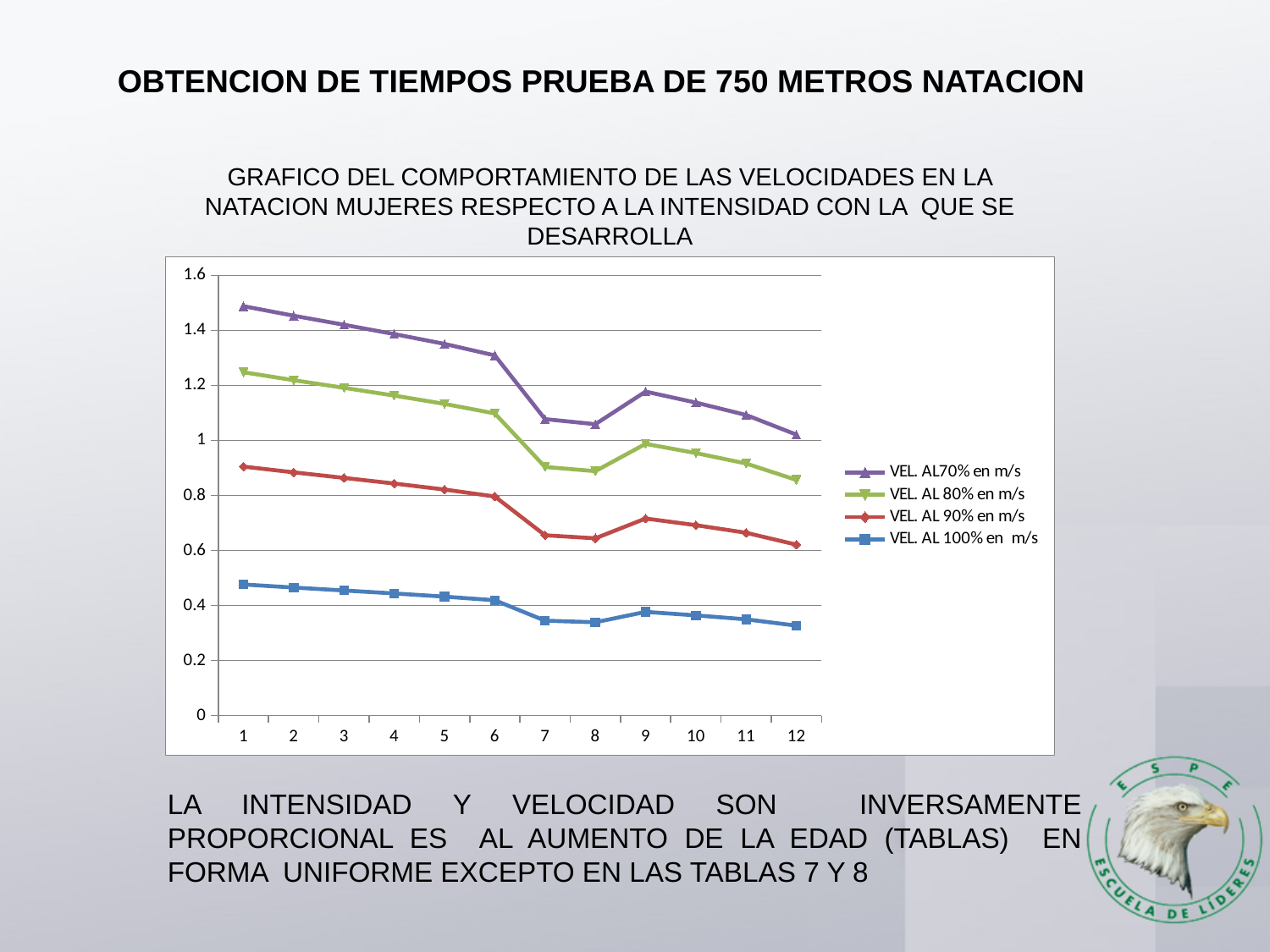
Is the value for VEL. AL 100% en m/s at category 8 greater or less than 0.4? less Which is larger at category 5: VEL. AL70% en m/s or VEL. AL 100% en m/s? VEL. AL70% en m/s Which series has the lowest values across the chart? VEL. AL 100% en m/s Which series has the highest values across the chart? VEL. AL70% en m/s Is the value for VEL. AL 80% en m/s at category 7 greater or less than 1? less How many series does the legend list? 4 At which category does the VEL. AL70% en m/s series reach its highest value? 1 How many categories are shown on the x axis? 12 Is the value for VEL. AL70% en m/s at category 1 greater or less than 1.4? greater What kind of chart is shown on the slide? line chart Do the values of the VEL. AL 90% en m/s series generally rise or fall from category 1 to category 12? fall What is the title of the chart? GRAFICO DEL COMPORTAMIENTO DE LAS VELOCIDADES EN LA NATACION MUJERES RESPECTO A LA INTENSIDAD CON LA QUE SE DESARROLLA